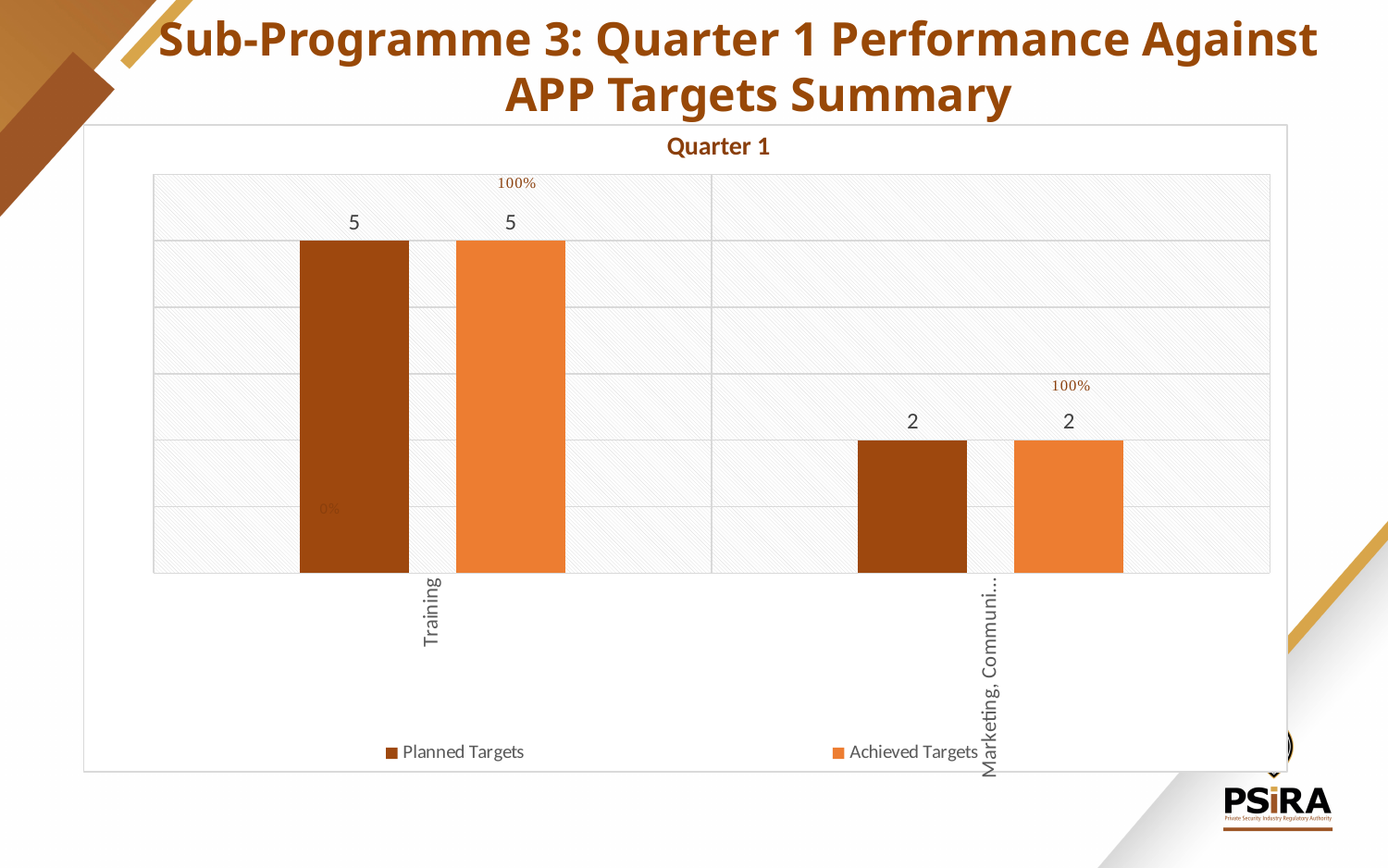
What is the Achieved Targets value for Training? 5 Which is larger: the Achieved Targets for Training or for Marketing, Communi...? Training What is the difference between the Planned Targets for Training and for Marketing, Communi...? 3 How many series does the legend list? 2 What is the Planned Targets value for the Marketing, Communi... category? 2 How many categories are shown on the x axis? 2 What is the Achieved Targets value for the Marketing, Communi... category? 2 What percentage label is shown above the Achieved Targets bar for Training? 100% What kind of chart is shown on the slide? Bar chart Which category has the highest Planned Targets value? Training What is the Planned Targets value for Training? 5 Which category has the lowest Achieved Targets value? Marketing, Communi...